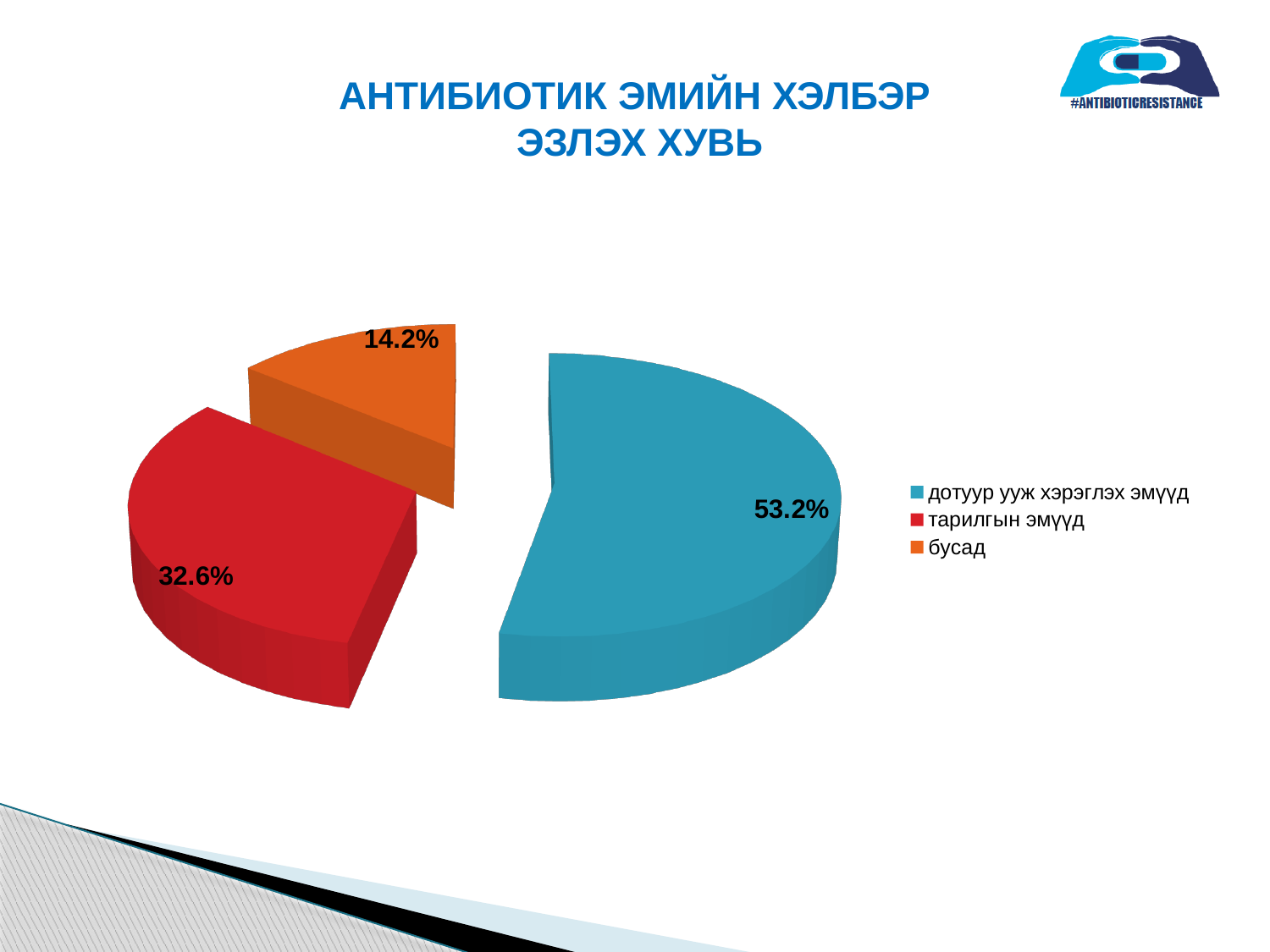
What share of the pie does "дотуурууж хэрэглэх эмүүд" have? 53.2% What share of the pie does "тарилгын эмүүд" have? 32.6% What colour is the slice for "тарилгын эмүүд"? Red What is the difference between the shares of "тарилгын эмүүд" and "бусад"? 18.4% What kind of chart is shown on the slide? Pie chart What share of the pie does "бусад" have? 14.2% How many entries does the legend list? 3 Which category has the smallest slice of the pie? бусад How many slices does the pie chart have? 3 Which category has the largest slice of the pie? дотуур ууж хэрэглэх эмүүд Which is larger: the share of "тарилгын эмүүд" or the share of "бусад"? тарилгын эмүүд What is the difference between the shares of "дотуур ууж хэрэглэх эмүүд" and "тарилгын эмүүд"? 20.6%